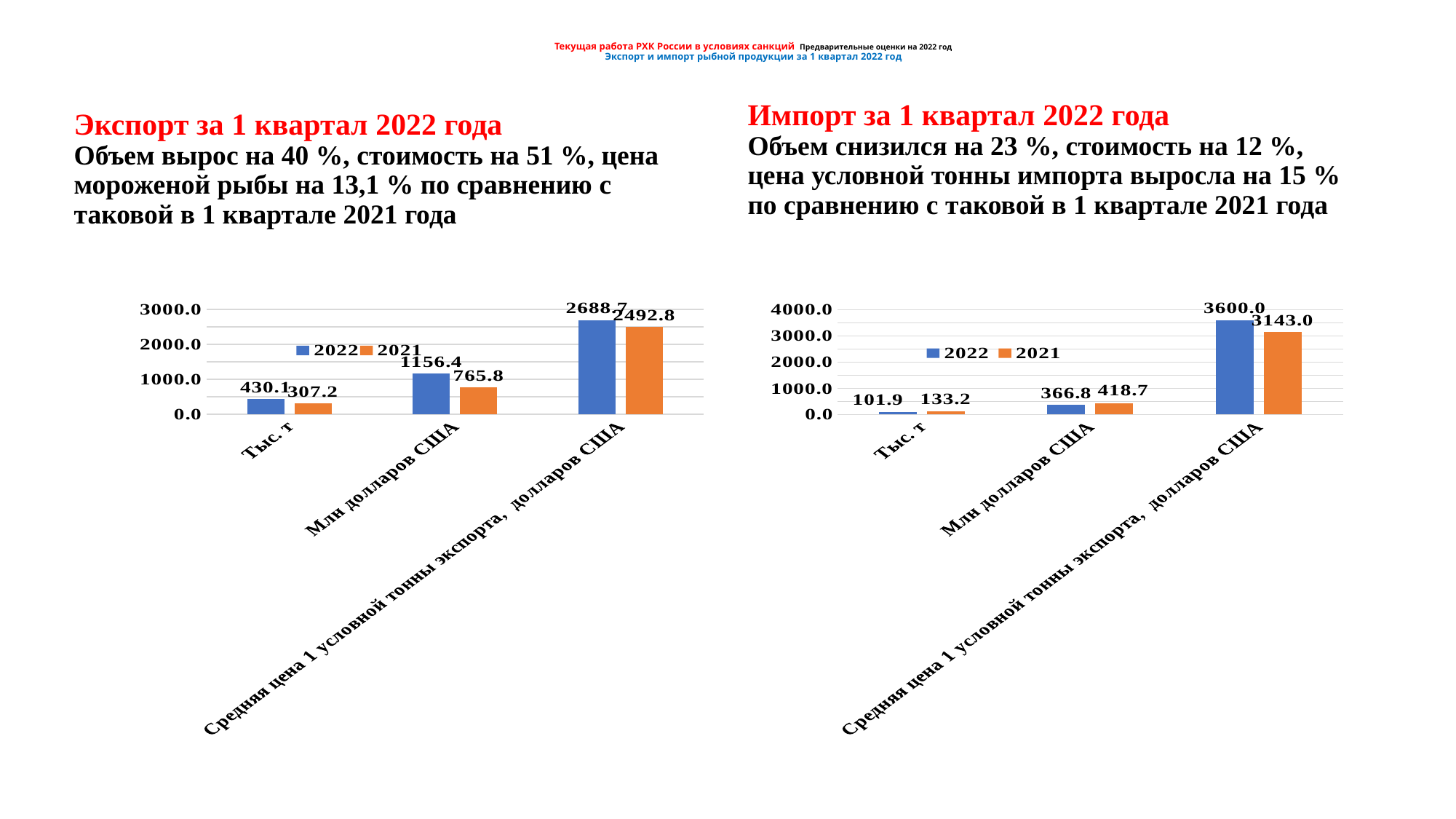
In the left chart, what is the 2021 value for Млн долларов США? 765.8 In the right chart, what is the 2021 value for Тыс. т? 133.2 In the right chart, which category has the lowest 2021 value? Тыс. т In the right chart, what is the 2022 value for Средняя цена 1 условной тонны экспорта, долларов США? 3600.0 In the left chart, what is the 2022 value for Тыс. т? 430.1 How many series does the legend of the left chart list? 2 In the right chart, what is the difference between the 2021 and 2022 values for Млн долларов США? 51.9 How many categories are shown on the x axis of the right chart? 3 In the right chart, which is larger for Тыс. т: the 2022 value or the 2021 value? 2021 What kind of chart is the left chart? Bar chart In the left chart, what is the difference between the 2022 and 2021 values for Млн долларов США? 390.6 In the left chart, which category has the highest 2022 value? Средняя цена 1 условной тонны экспорта, долларов США